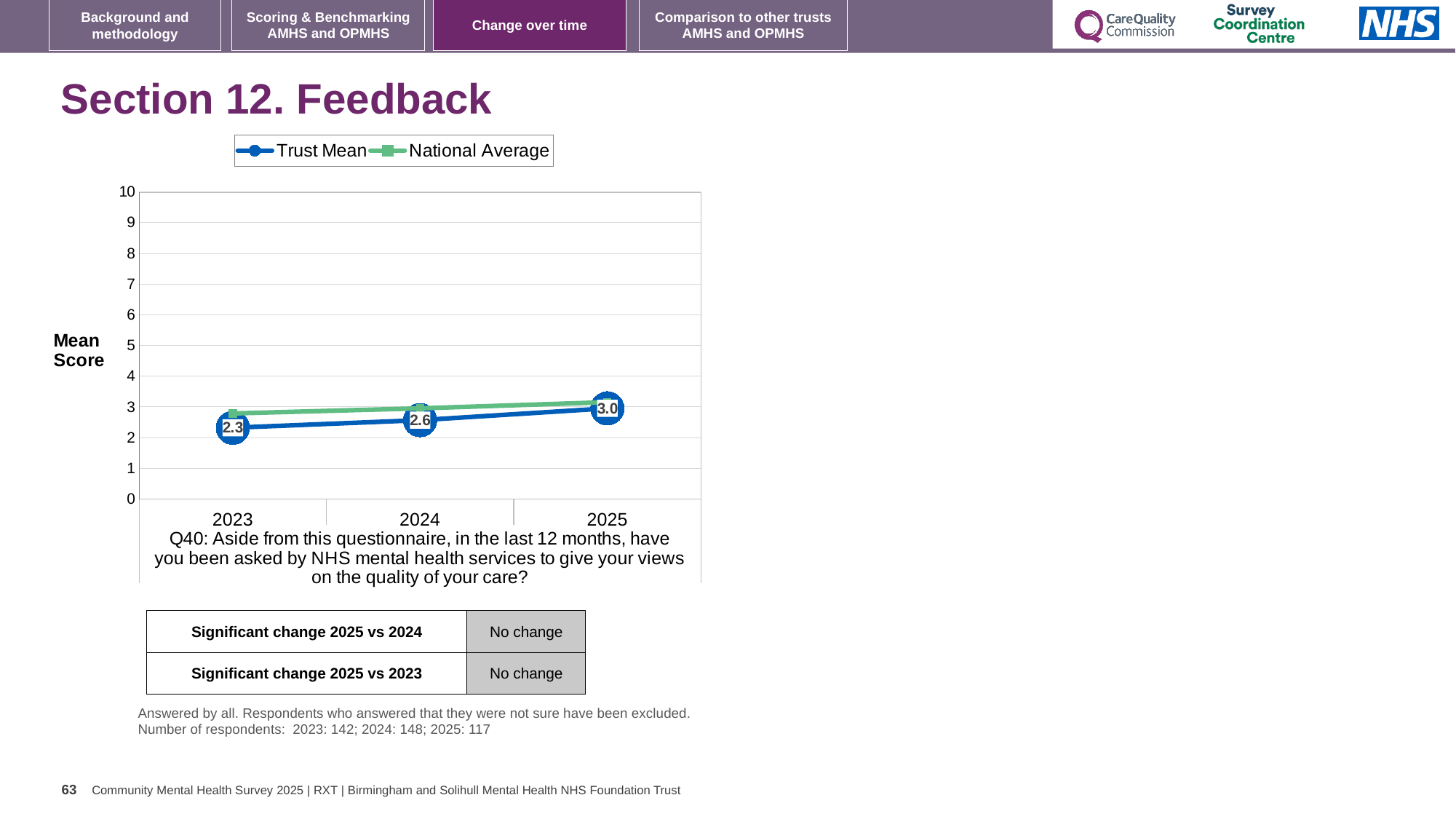
What is the Trust Mean value for 2025? 3.0 Does the Trust Mean rise or fall from 2023 to 2025? Rise What is the difference between the Trust Mean in 2025 and in 2023? 0.7 What is the Trust Mean value for 2023? 2.3 Which is larger, the Trust Mean in 2024 or in 2023? 2024 In which year is the Trust Mean highest? 2025 What is the Trust Mean value for 2024? 2.6 Is the National Average value for 2023 greater or less than 2? greater What kind of chart is shown on the slide? Line chart How many series does the legend list? 2 In which year is the Trust Mean lowest? 2023 How many years are plotted on the x axis? 3